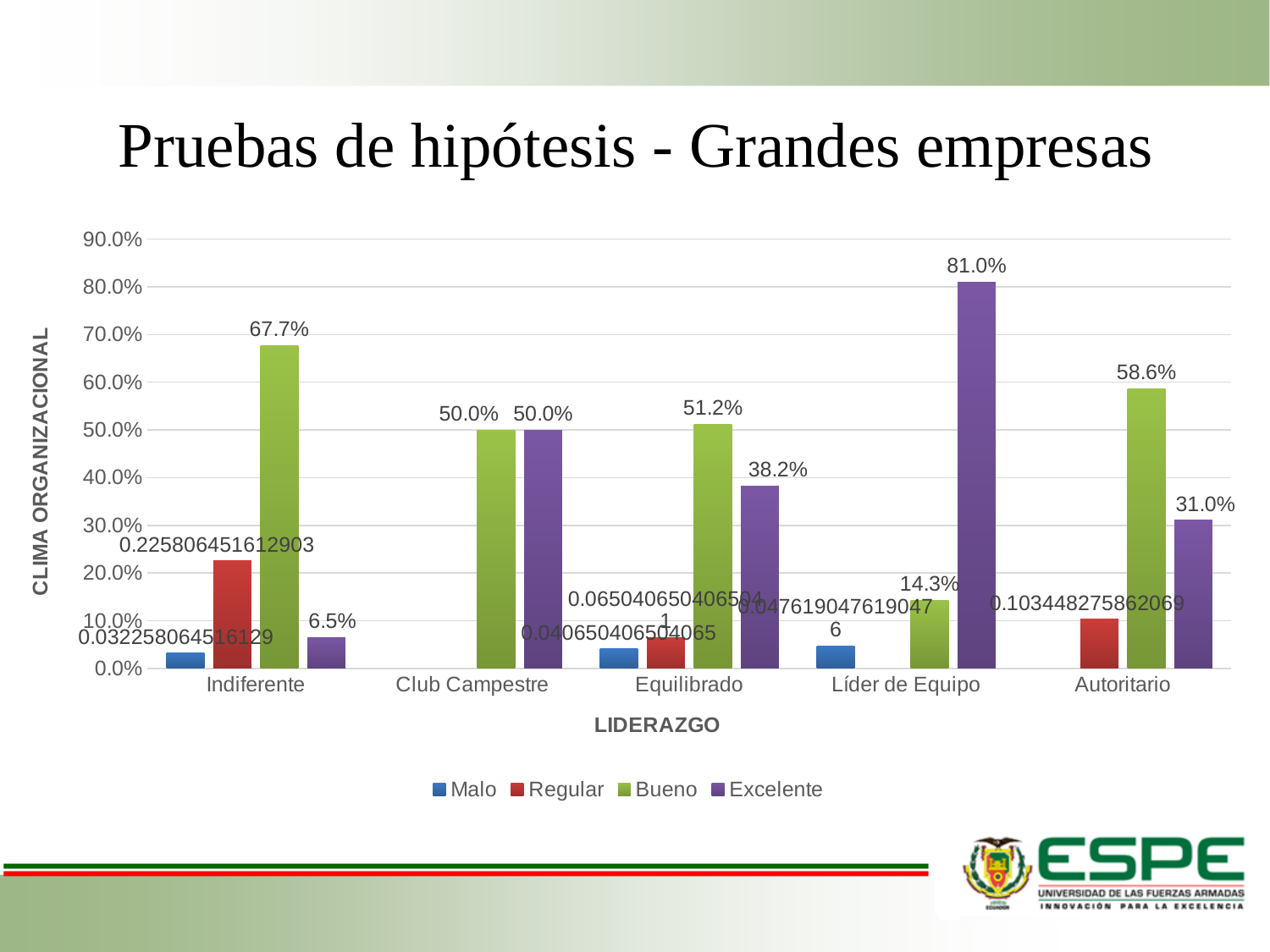
What type of chart is shown on the slide? bar chart What is the value for Bueno in the Indiferente category? 67.7% What is the value for Bueno in the Equilibrado category? 51.2% Which is larger in the Autoritario category, Bueno or Excelente? Bueno Which category has the highest Excelente value? Líder de Equipo What is the value for Excelente in the Líder de Equipo category? 81.0% What is the value for Excelente in the Autoritario category? 31.0% How many series does the legend list? 4 How many leadership categories are shown on the x axis? 5 What is the title of the x axis? LIDERAZGO Which category has the lowest Bueno value? Líder de Equipo What is the difference between the Bueno and Excelente values in the Equilibrado category? 13.0%